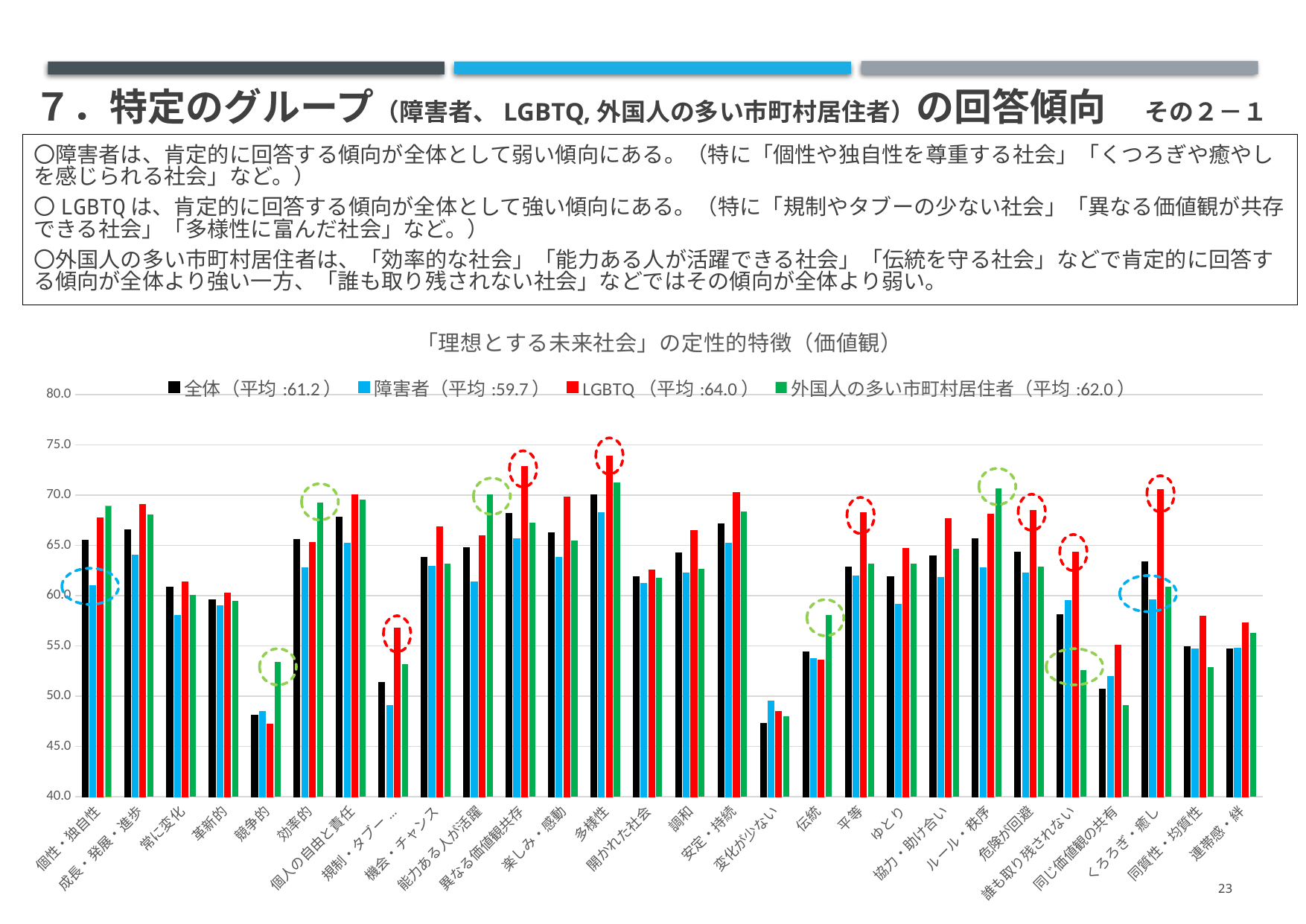
At 多様性, which is larger: the value for 障害者 or the value for LGBTQ? LGBTQ What is the title of the chart? 「理想とする未来社会」の定性的特徴（価値観） At 競争的, which is larger: the value for LGBTQ or the value for 外国人の多い市町村居住者? 外国人の多い市町村居住者 How many series does the chart legend list? 4 At 伝統, which is larger: the value for 全体 or the value for 外国人の多い市町村居住者? 外国人の多い市町村居住者 Is the value for 外国人の多い市町村居住者 at 誰も取り残されない greater or less than 55? less According to the legend, what is the average (平均) for the LGBTQ series? 64.0 How many categories are shown along the x axis of the chart? 28 What kind of chart is shown on the slide? bar chart Is the value for 外国人の多い市町村居住者 at 効率的 greater or less than 65? greater Is the value for 全体 at 変化が少ない greater or less than 50? less